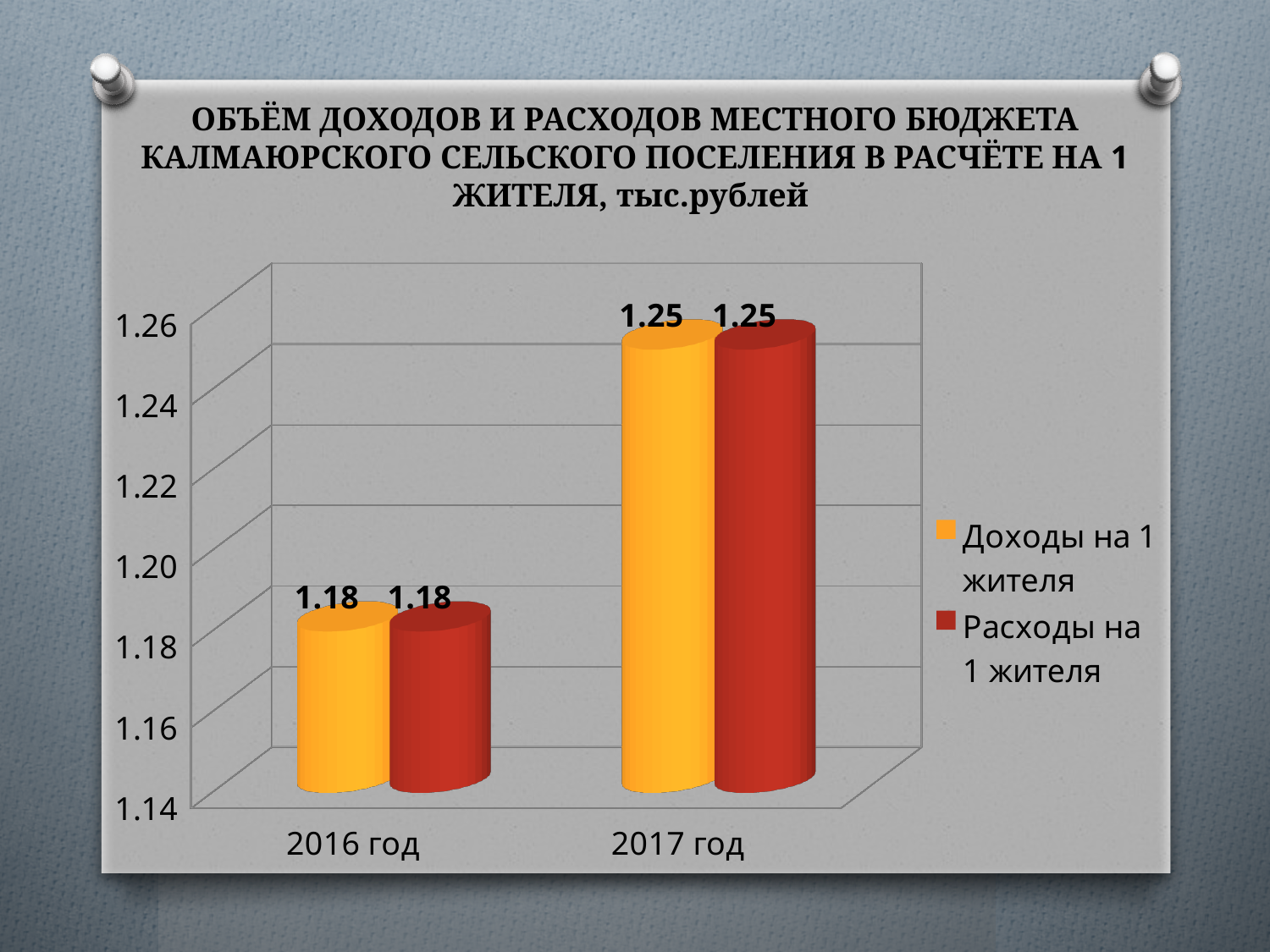
Which year has the lowest value for 'Расходы на 1 жителя'? 2016 год What is the value of 'Доходы на 1 жителя' for 2016 год? 1.18 How many categories (years) are shown on the x axis? 2 Which year has the highest value for 'Доходы на 1 жителя'? 2017 год Is the value for 'Доходы на 1 жителя' in 2017 год greater or less than 1.20? greater What is the value of 'Расходы на 1 жителя' for 2017 год? 1.25 What is the value of 'Расходы на 1 жителя' for 2016 год? 1.18 How many series does the legend list? 2 Do the values for 'Расходы на 1 жителя' rise or fall from 2016 год to 2017 год? Rise What is the difference between 'Доходы на 1 жителя' in 2017 год and in 2016 год? 0.07 What is the value of 'Доходы на 1 жителя' for 2017 год? 1.25 What kind of chart is shown on the slide? Bar chart